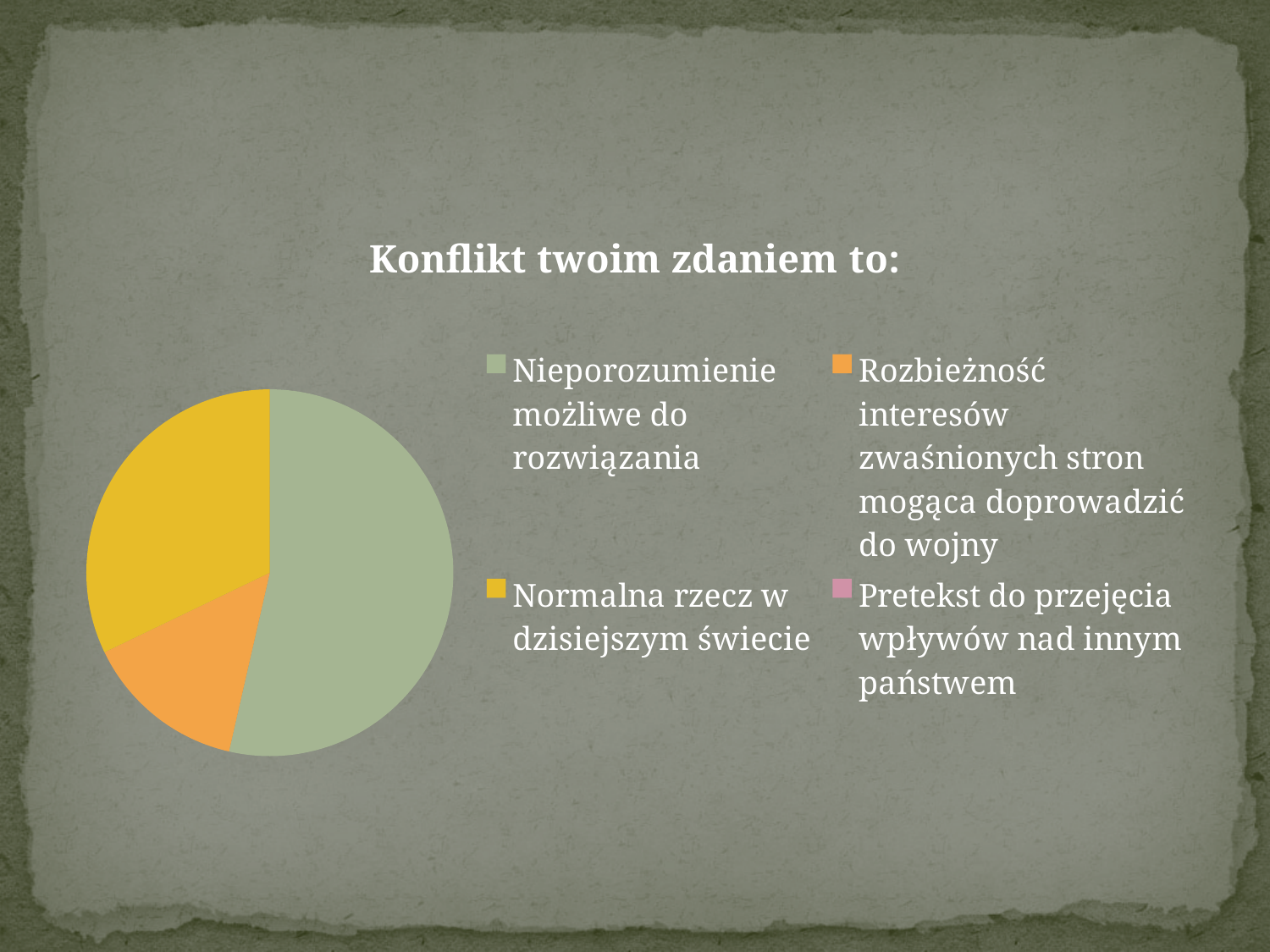
What colour is the largest slice of the pie? green Which legend entry has no visible slice in the pie? Pretekst do przejęcia wpływów nad innym państwem Which category is represented by the orange slice? Rozbieżność interesów zwaśnionych stron mogąca doprowadzić do wojny Which is larger: the slice for "Normalna rzecz w dzisiejszym świecie" or the slice for "Rozbieżność interesów zwaśnionych stron mogąca doprowadzić do wojny"? Normalna rzecz w dzisiejszym świecie Which is larger: the slice for "Nieporozumienie możliwe do rozwiązania" or the slice for "Normalna rzecz w dzisiejszym świecie"? Nieporozumienie możliwe do rozwiązania Which category is represented by the yellow slice? Normalna rzecz w dzisiejszym świecie What kind of chart is shown on the slide? pie chart How many entries does the chart's legend list? 4 Which category has the largest slice of the pie? Nieporozumienie możliwe do rozwiązania What is the title of the chart? Konflikt twoim zdaniem to: